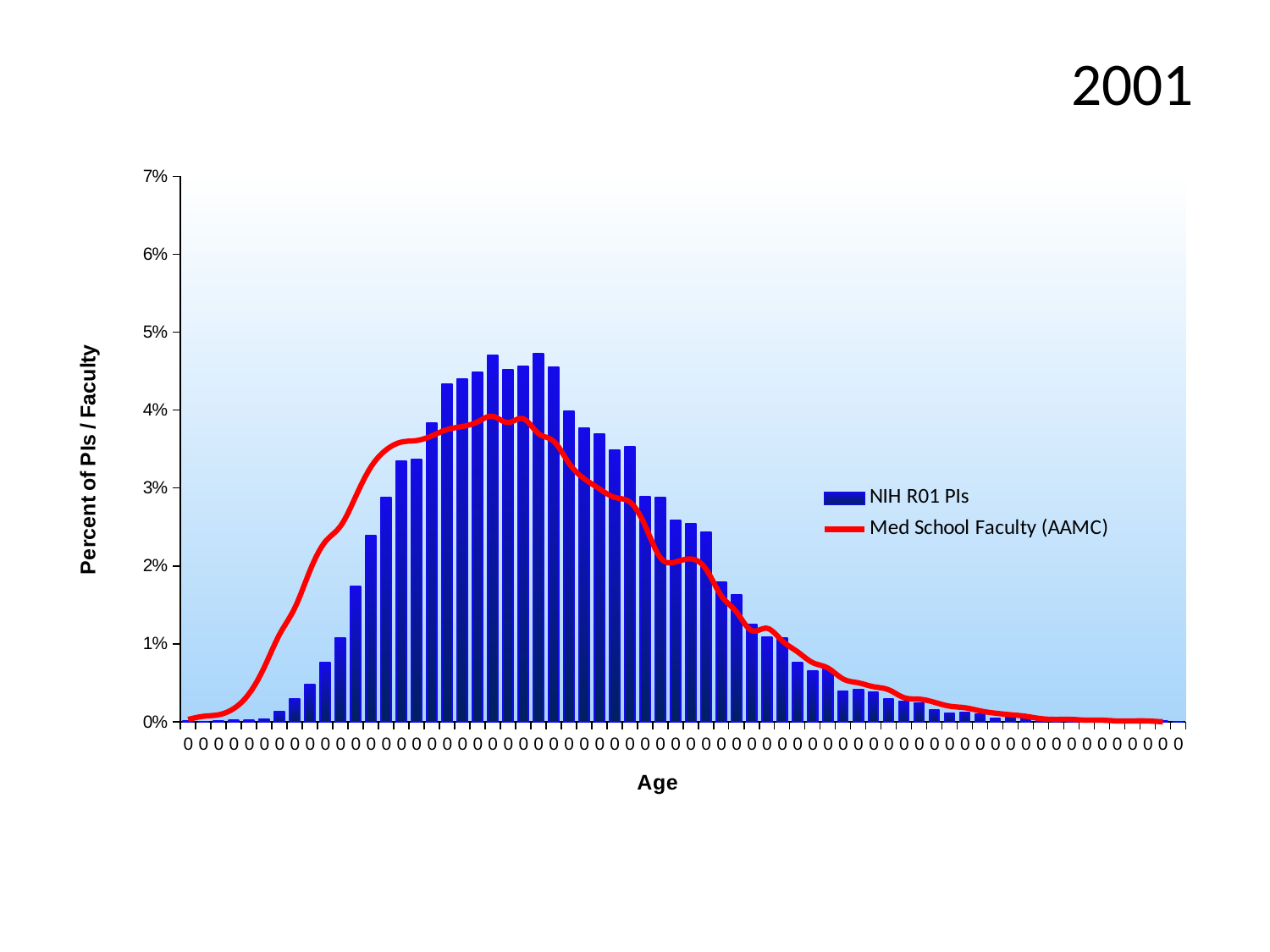
Is the value of the Med School Faculty (AAMC) line at the far right end of the x axis greater or less than 1%? less Is the highest value reached by the NIH R01 PIs bars greater or less than 4%? greater Which series reaches the higher peak value, NIH R01 PIs or Med School Faculty (AAMC)? NIH R01 PIs What kind of chart is used to plot the Med School Faculty (AAMC) series? line chart What kind of chart is used to plot the NIH R01 PIs series? bar chart What is the title of the vertical axis? Percent of PIs / Faculty Is the highest value reached by the NIH R01 PIs bars greater or less than 5%? less How many series does the legend list? 2 Moving from the peak toward the right end of the x axis, do the NIH R01 PIs bar values rise or fall? fall What are the two series named in the legend? NIH R01 PIs and Med School Faculty (AAMC)